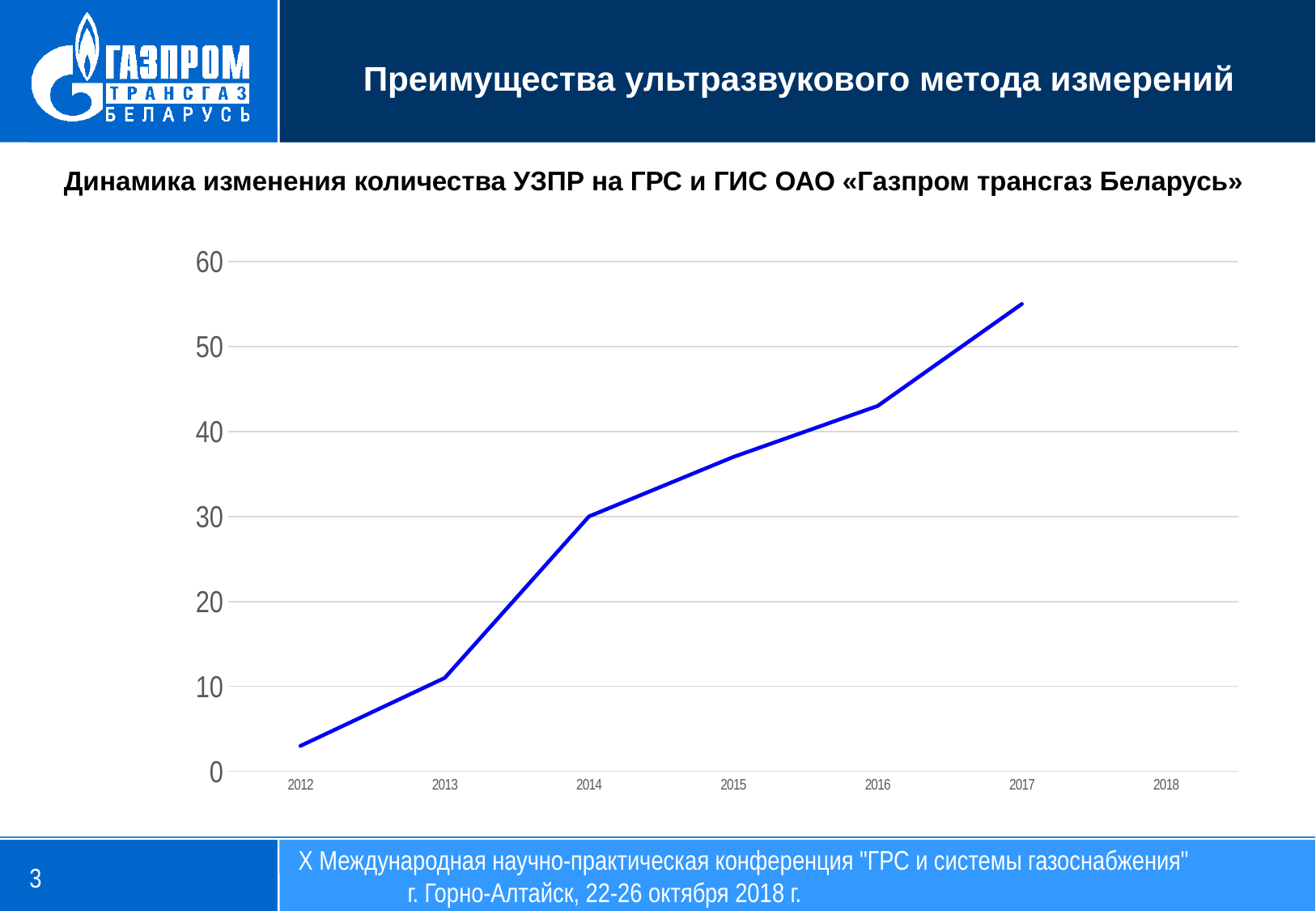
Which year has the larger value, 2014 or 2016? 2016 How many year labels are shown on the x axis? 7 What is the title of the chart? Динамика изменения количества УЗПР на ГРС и ГИС ОАО «Газпром трансгаз Беларусь» What kind of chart is shown on the slide? line chart Is the value for 2015 greater or less than 30? greater Which year has the highest value on the chart? 2017 Is the value for 2016 greater or less than 40? greater Do the values rise or fall from 2012 to 2017? rise Is the value for 2013 greater or less than 20? less Which year has the lowest value on the chart? 2012